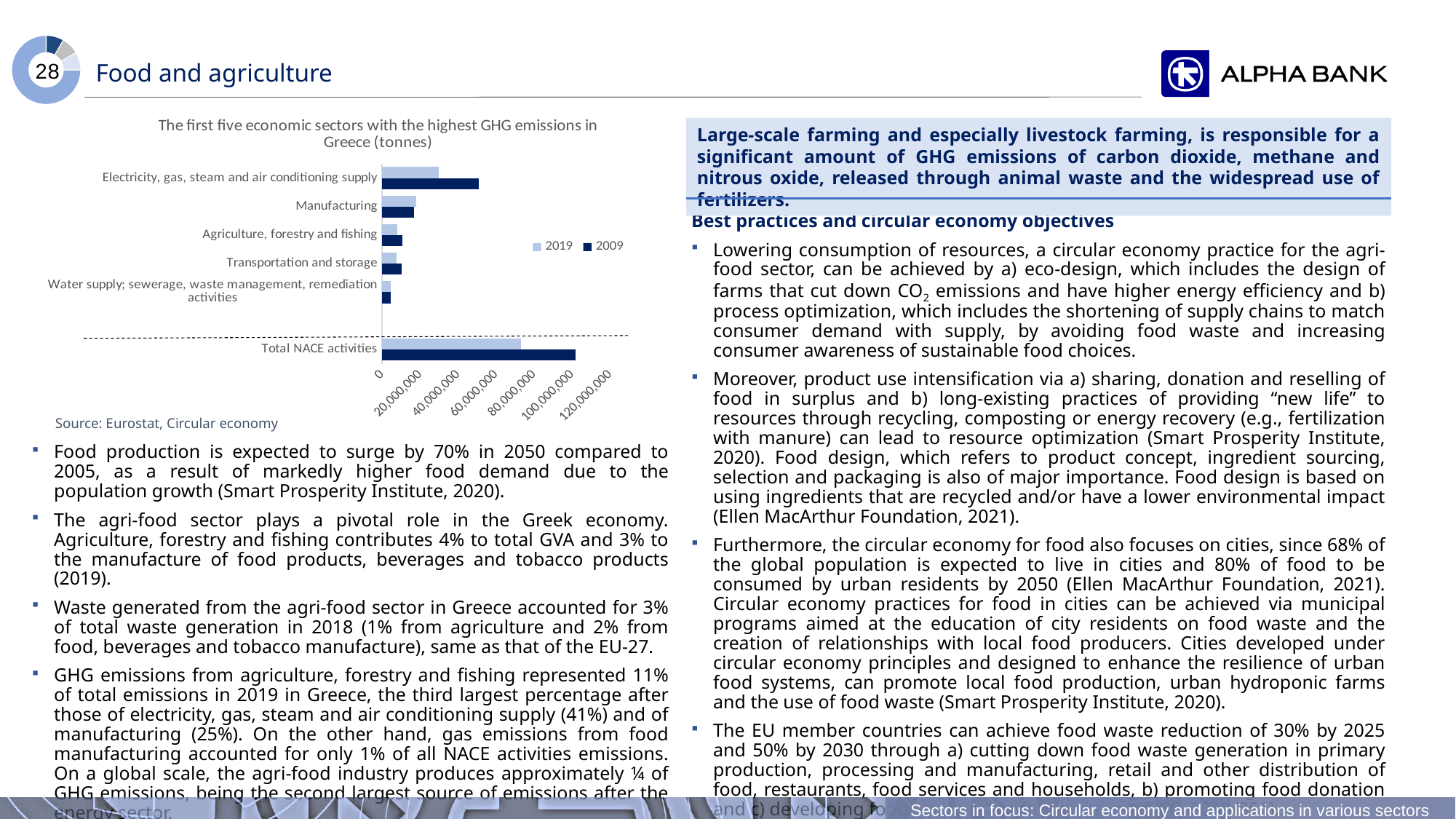
Among the five individual economic sectors, which has the highest GHG emissions? Electricity, gas, steam and air conditioning supply Is the 2009 value for Total NACE activities greater or less than 80,000,000? greater Which category has the longest bars in the chart? Total NACE activities Is the 2009 value for Electricity, gas, steam and air conditioning supply greater or less than 40,000,000? greater How many series does the chart legend list? 2 For Electricity, gas, steam and air conditioning supply, which year shows higher GHG emissions, 2019 or 2009? 2009 Is the 2019 value for Total NACE activities greater or less than 80,000,000? less What kind of chart is shown on the slide? Bar chart Which of the five individual economic sectors has the lowest GHG emissions? Water supply; sewerage, waste management, remediation activities How many categories are plotted on the chart's vertical axis? 6 Which years are listed in the chart legend? 2019 and 2009 What is the source cited below the chart? Eurostat, Circular economy